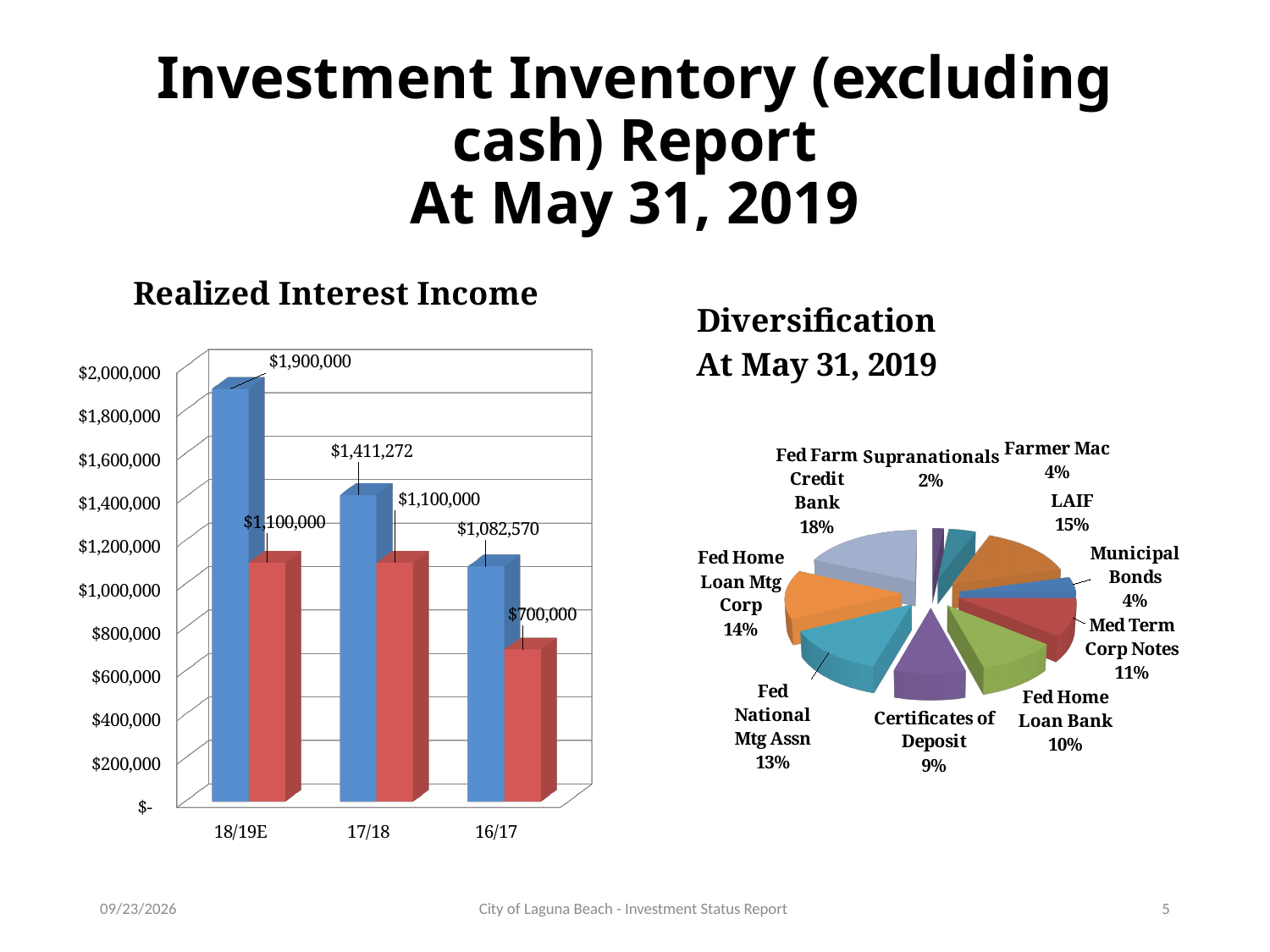
In the Realized Interest Income chart, how many categories are shown on the x axis? 3 In the Realized Interest Income chart, do the blue bars rise or fall from 18/19E to 16/17? fall In the Realized Interest Income chart, what is the value of the blue bar for 18/19E? $1,900,000 In the Realized Interest Income chart, what is the value of the red bar for 16/17? $700,000 How many slices does the Diversification At May 31, 2019 pie chart have? 10 In the Realized Interest Income chart, which category has the highest blue bar? 18/19E In the Diversification At May 31, 2019 chart, what share does Fed Farm Credit Bank hold? 18% In the Realized Interest Income chart, what is the value of the blue bar for 17/18? $1,411,272 In the Realized Interest Income chart, what is the difference between the blue bar and the red bar for 18/19E? $800,000 In the Diversification At May 31, 2019 chart, which is larger, LAIF or Fed Home Loan Mtg Corp? LAIF What kind of chart is the Realized Interest Income chart? bar chart In the Diversification At May 31, 2019 chart, which category has the smallest share? Supranationals